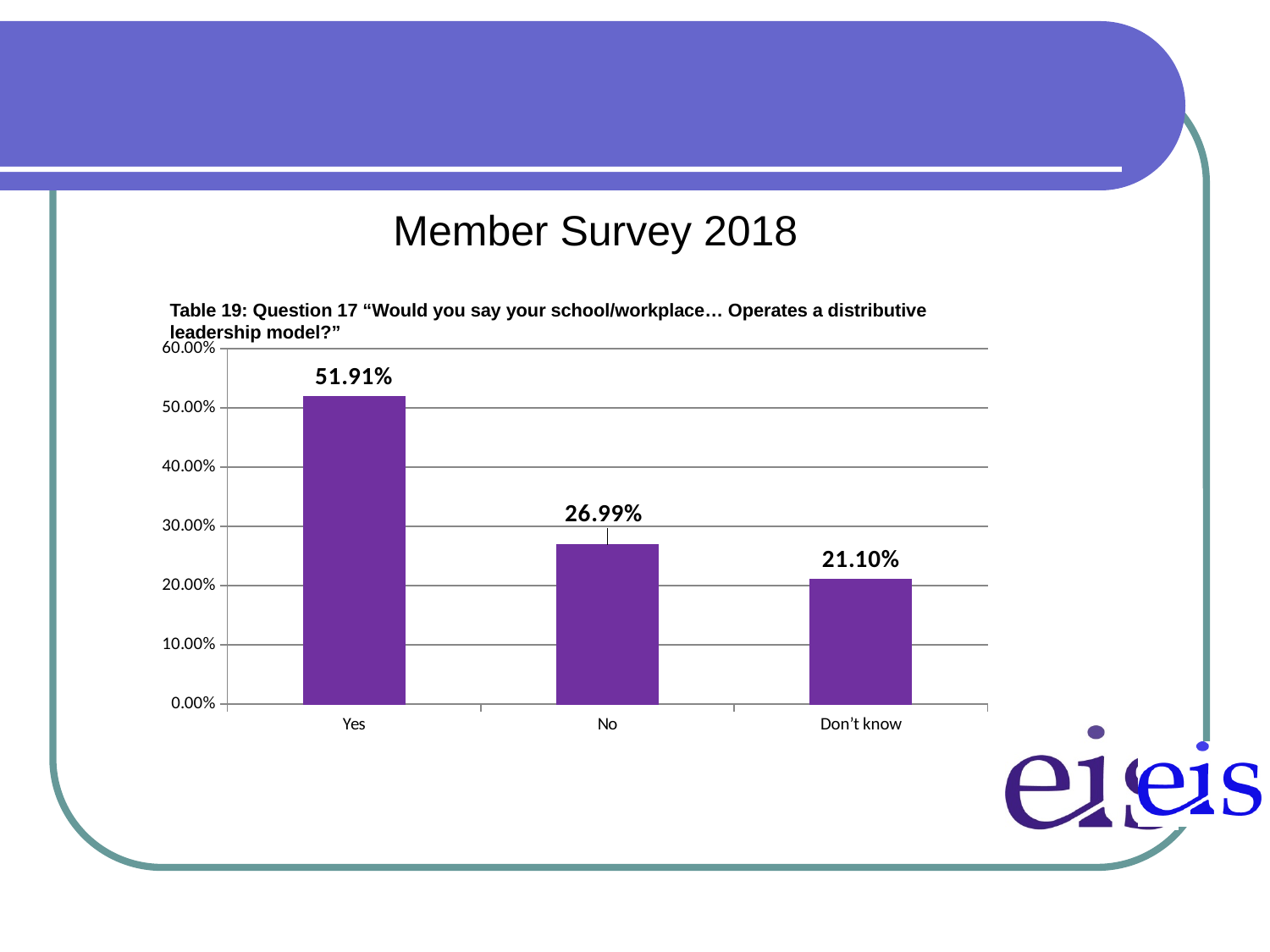
What is the value for Don't know? 21.10% What kind of chart is shown on the slide? bar chart Is the value for Yes greater or less than 50.00%? greater How many categories are shown on the x axis? 3 What is the difference between the values for No and Don't know? 5.89% Which category has the highest value? Yes What is the value for Yes? 51.91% What is the value for No? 26.99% What is the difference between the values for Yes and No? 24.92% Do the values rise or fall from left to right along the x axis? fall Which is larger, the value for No or the value for Don't know? No Which category has the lowest value? Don't know